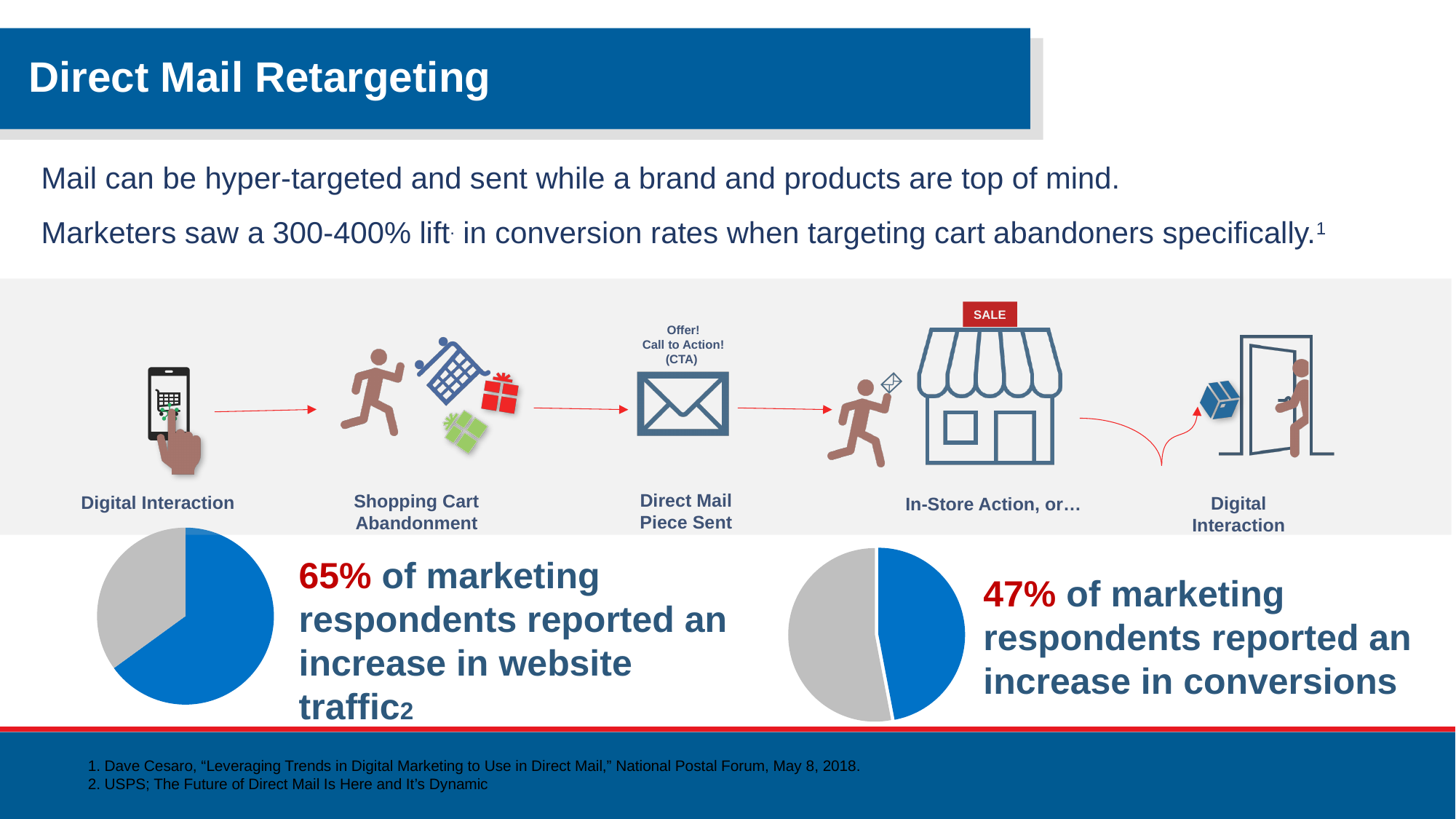
How many slices does the right pie chart have? 2 What kind of chart is shown on the right, next to the text about conversions? Pie chart In the right pie chart, is the blue slice greater or less than 50% of the pie? less In the left pie chart, what share of marketing respondents reported an increase in website traffic? 65% In the right pie chart, what share of marketing respondents reported an increase in conversions? 47% How many slices does the left pie chart have? 2 Which is larger: the share of respondents reporting an increase in website traffic (left pie) or the share reporting an increase in conversions (right pie)? Increase in website traffic What kind of chart is shown on the left, next to the text about website traffic? Pie chart In the left pie chart, is the blue slice greater or less than 50% of the pie? greater In the right pie chart, which slice is larger, the blue one or the grey one? Grey What is the difference in percentage points between the share reporting an increase in website traffic (left pie) and the share reporting an increase in conversions (right pie)? 18 percentage points In the left pie chart, what colour is the slice representing the 65% of respondents who reported an increase in website traffic? Blue